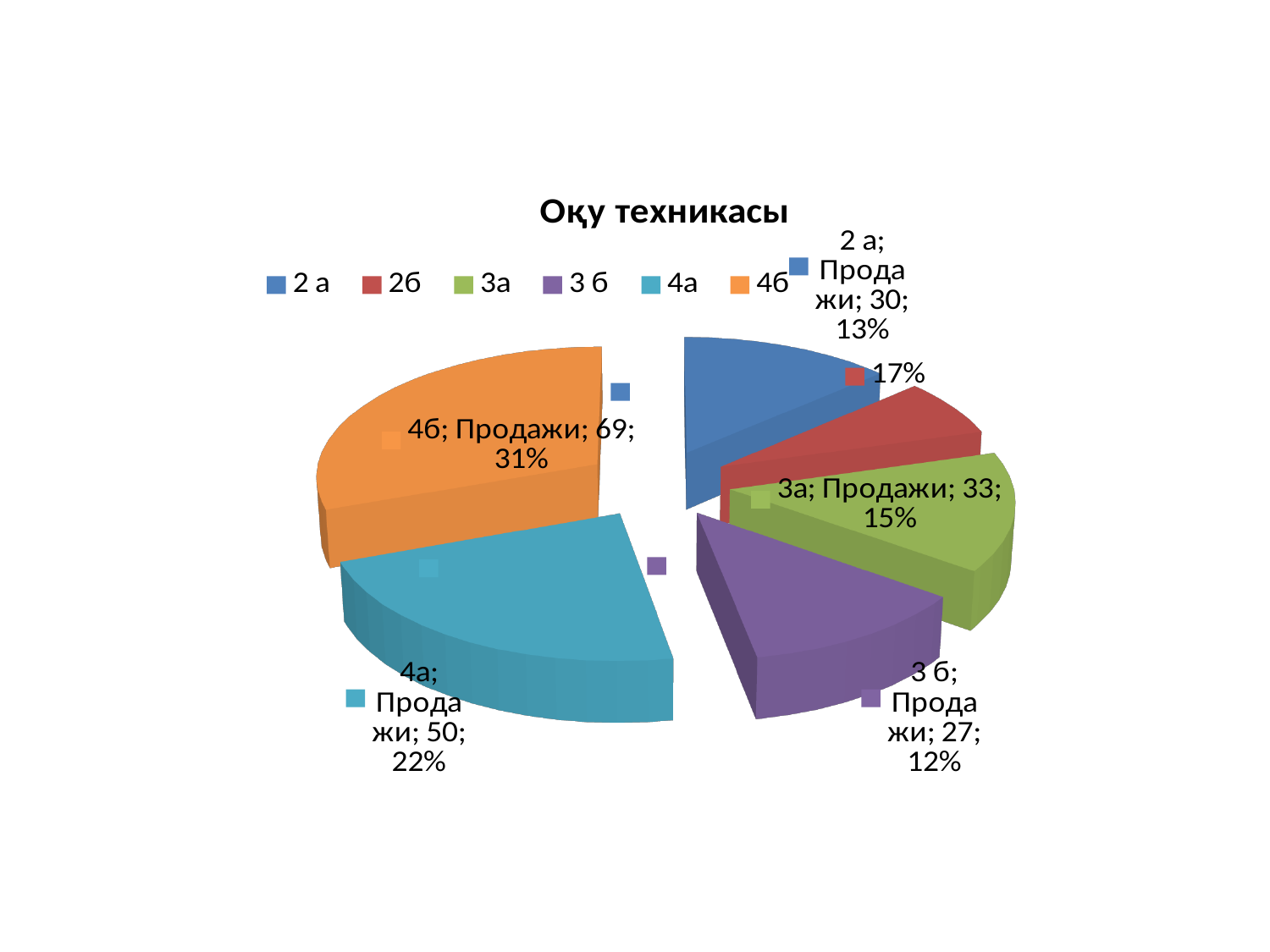
What is the value for 4б? 69 What kind of chart is shown on the slide? pie chart What is the difference between the values for 4б and 4а? 19 Which category has the smallest slice? 2б How many categories does the legend list? 6 What is the value for 2 а? 30 What is the value for 4а? 50 Which category has the largest slice? 4б What is the title of the chart? Оқу техникасы What is the value for 3 б? 27 What share of the pie does 4б represent? 31%